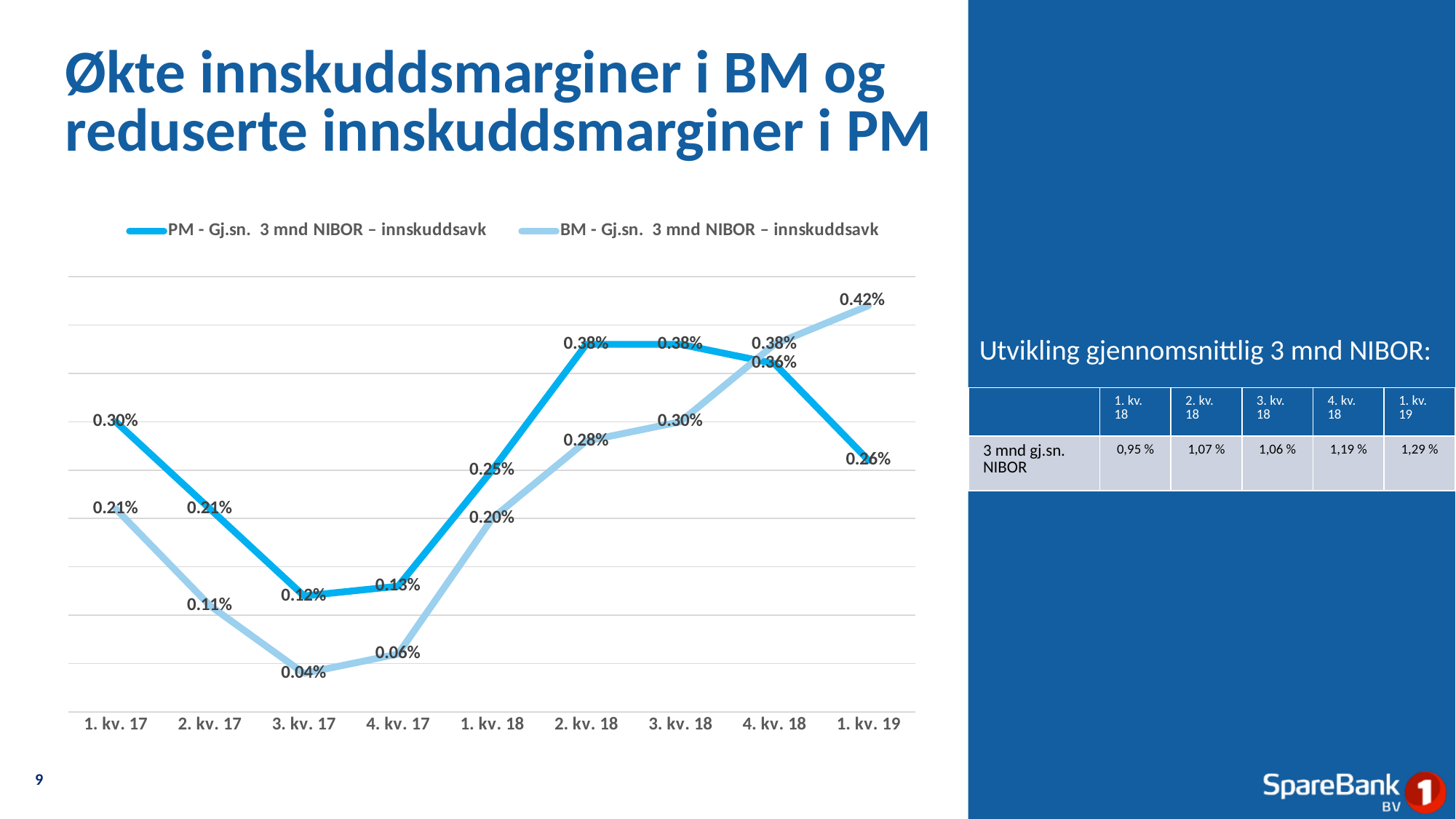
At 4. kv. 18, which series has the higher value, PM or BM? BM In which quarter does the PM series reach its lowest value? 3. kv. 17 What is the value of the PM - Gj.sn. 3 mnd NIBOR – innskuddsavk series at 1. kv. 17? 0.30% Which series is drawn in the lighter blue colour? BM - Gj.sn. 3 mnd NIBOR – innskuddsavk What is the value of the BM - Gj.sn. 3 mnd NIBOR – innskuddsavk series at 3. kv. 17? 0.04% In which quarter does the BM series reach its highest value? 1. kv. 19 What is the value of the BM series at 1. kv. 18? 0.20% How many series does the chart legend list? 2 How many quarters are shown on the x axis of the chart? 9 What is the difference between the BM value and the PM value at 1. kv. 19? 0.16% What type of chart is shown on the slide? Line chart Does the BM series rise or fall from 3. kv. 17 to 1. kv. 19? Rise